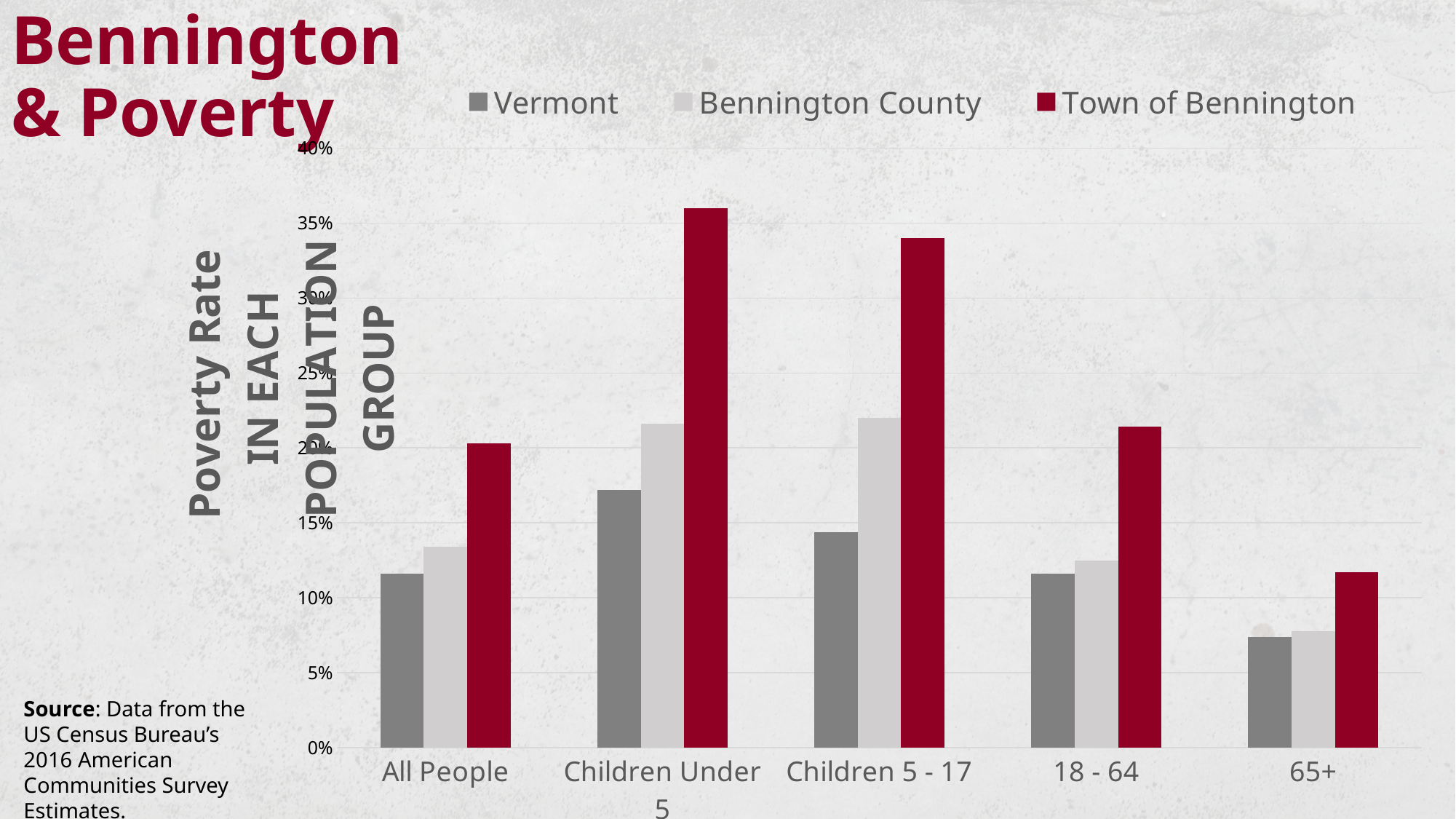
For Children 5 - 17, which is larger: the Vermont value or the Bennington County value? Bennington County For the Town of Bennington series, which population group has the highest poverty rate? Children Under 5 Is the Town of Bennington value for Children Under 5 greater or less than 30%? greater How many population groups are shown along the x axis? 5 For the Vermont series, which population group has the highest poverty rate? Children Under 5 Is the Town of Bennington value for 65+ greater or less than 10%? greater For the Town of Bennington series, which population group has the lowest poverty rate? 65+ How many series does the legend list? 3 Is the Vermont value for All People greater or less than 15%? less Which series is shown in dark red in the legend? Town of Bennington What kind of chart is shown on the slide? bar chart